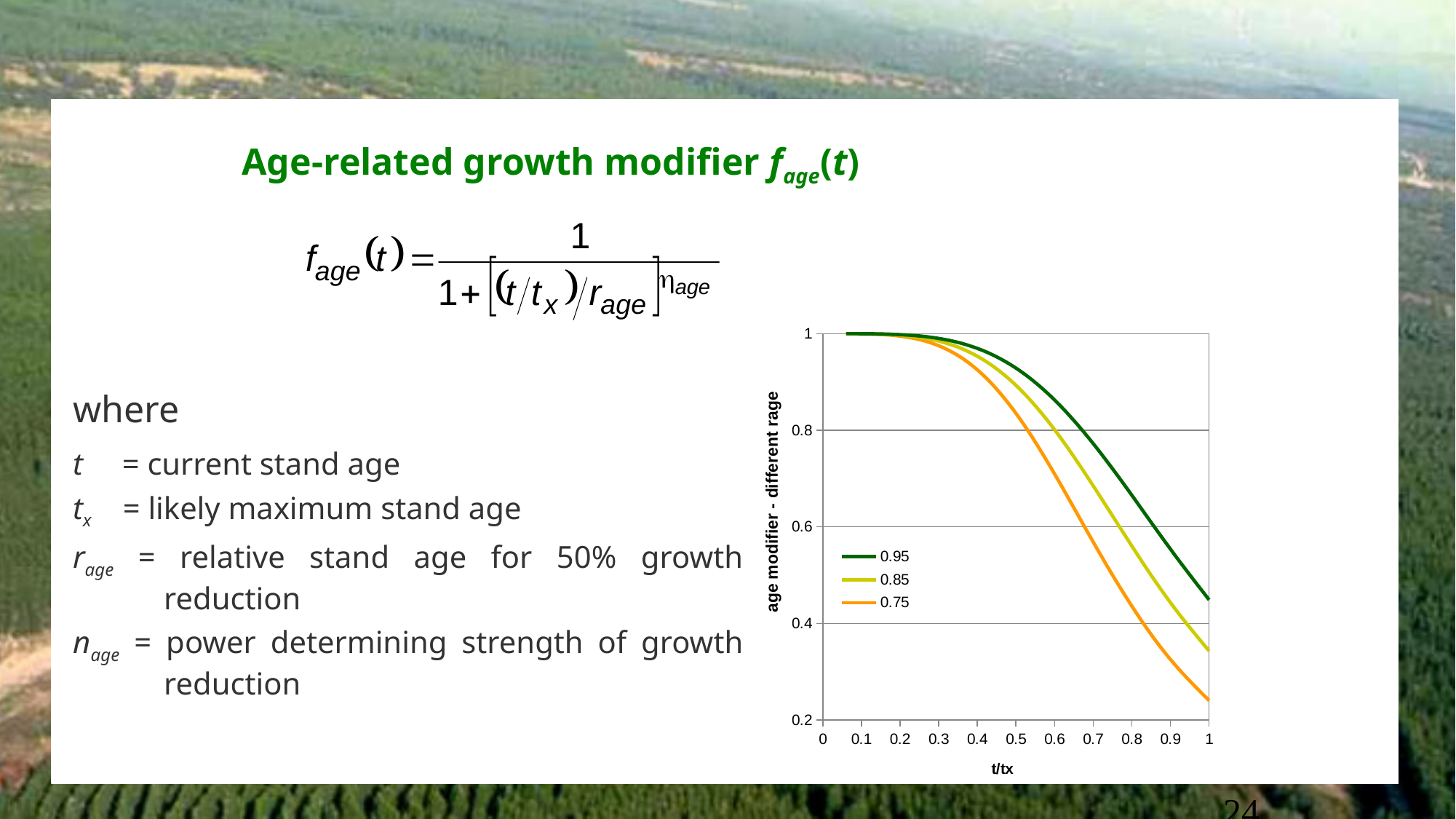
What is the label of the x axis of the chart? t/tx Which series has the highest value at t/tx = 1? 0.95 What kind of chart is shown on the slide? line chart How many series does the chart legend list? 3 At t/tx = 1, is the value of the 0.75 series greater or less than 0.4? less At t/tx = 0.8, is the value of the 0.75 series greater or less than 0.6? less Which series has the lowest value at t/tx = 1? 0.75 At t/tx = 0.6, is the value of the 0.95 series greater or less than 0.8? greater Do the values of the 0.95 series rise or fall as t/tx increases? fall At t/tx = 0.8, which series has the larger value, 0.95 or 0.75? 0.95 What are the three series listed in the chart legend? 0.95, 0.85, 0.75